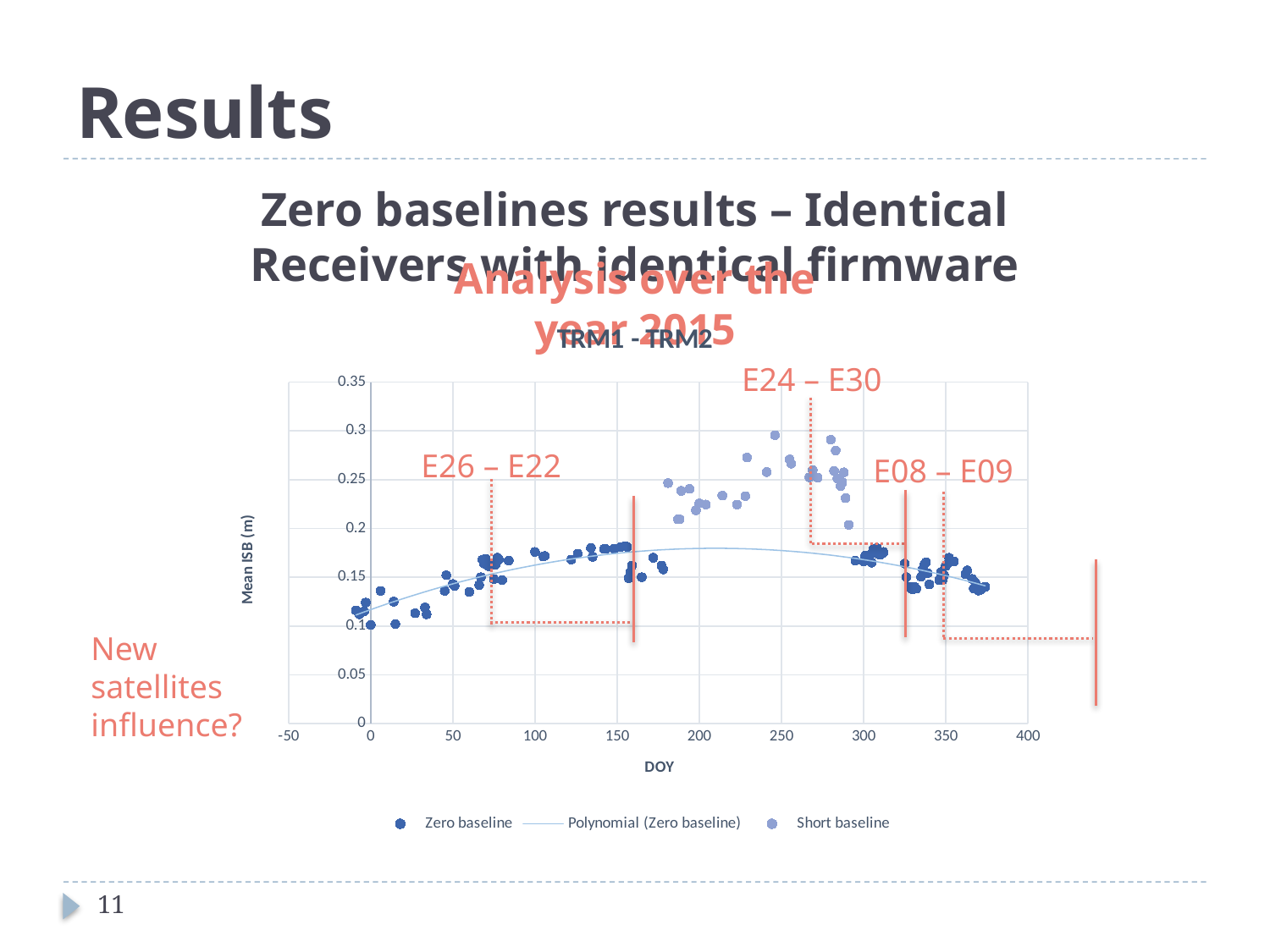
Is the highest Short baseline value (near DOY 250) greater or less than 0.25? greater What is the title of the chart? TRM1 - TRM2 Are the Zero baseline values near DOY 0 greater or less than 0.15? less Around DOY 250, which series has the higher Mean ISB values, Short baseline or Zero baseline? Short baseline What kind of chart is shown on the slide? scatter chart How many entries does the chart legend list? 3 Do the Zero baseline values rise or fall between DOY 300 and DOY 370? fall What is the label of the chart's x axis? DOY What is the maximum value shown on the y axis of the chart? 0.35 Do the Zero baseline values rise or fall between DOY 0 and DOY 150? rise